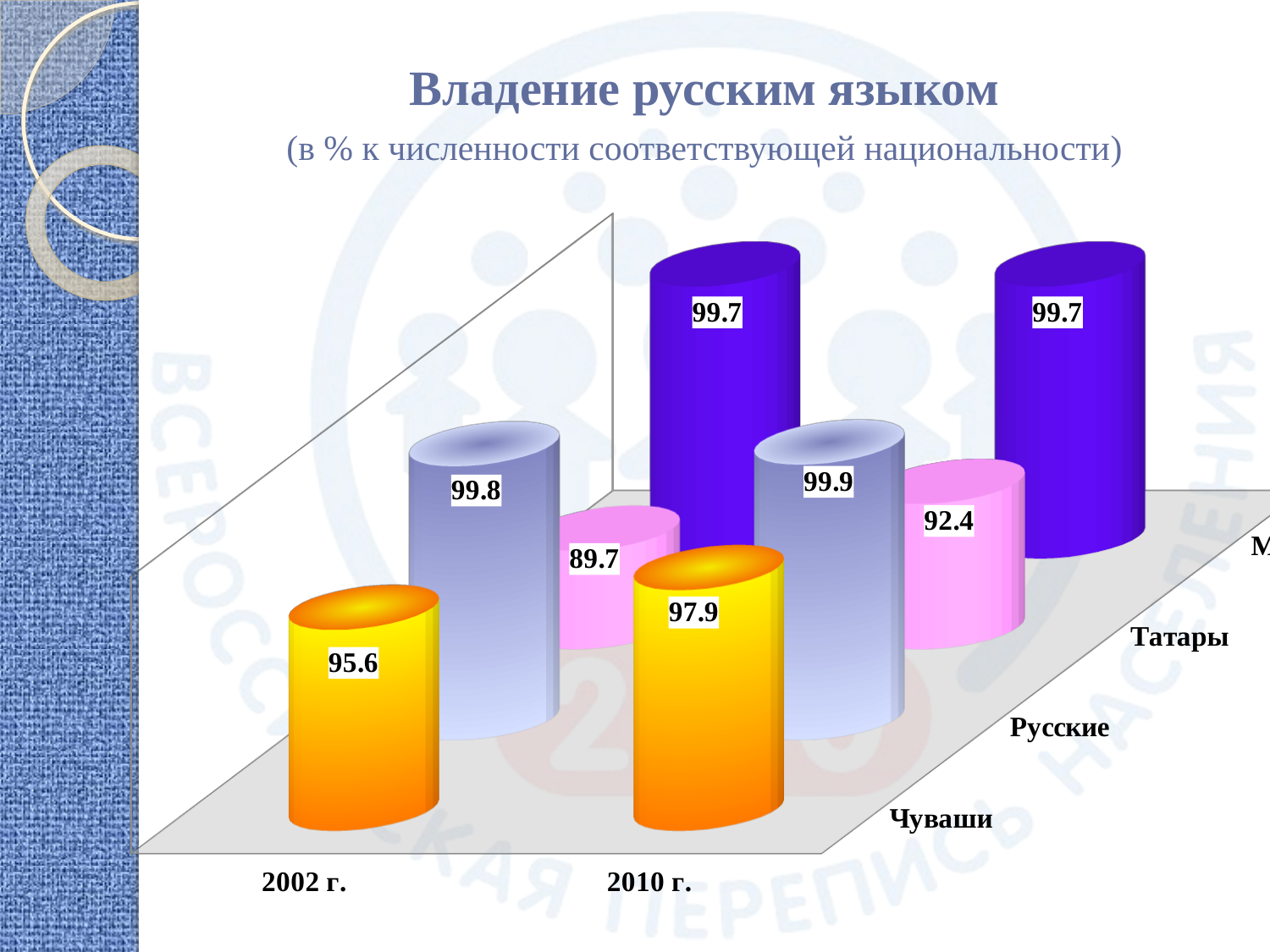
What is the value for Чуваши in 2010 г.? 97.9 What kind of chart is shown on the slide? bar chart Does the value for Татары rise or fall from 2002 г. to 2010 г.? rise What is the value for Татары in 2010 г.? 92.4 What is the value for Чуваши in 2002 г.? 95.6 Which is larger in 2002 г.: the value for Чуваши or the value for Татары? Чуваши What is the value for Русские in 2002 г.? 99.8 What is the value for Татары in 2002 г.? 89.7 What is the title of the chart? Владение русским языком By how much did the value for Татары increase from 2002 г. to 2010 г.? 2.7 What is the difference between the Чуваши values for 2010 г. and 2002 г.? 2.3 What is the value for Русские in 2010 г.? 99.9